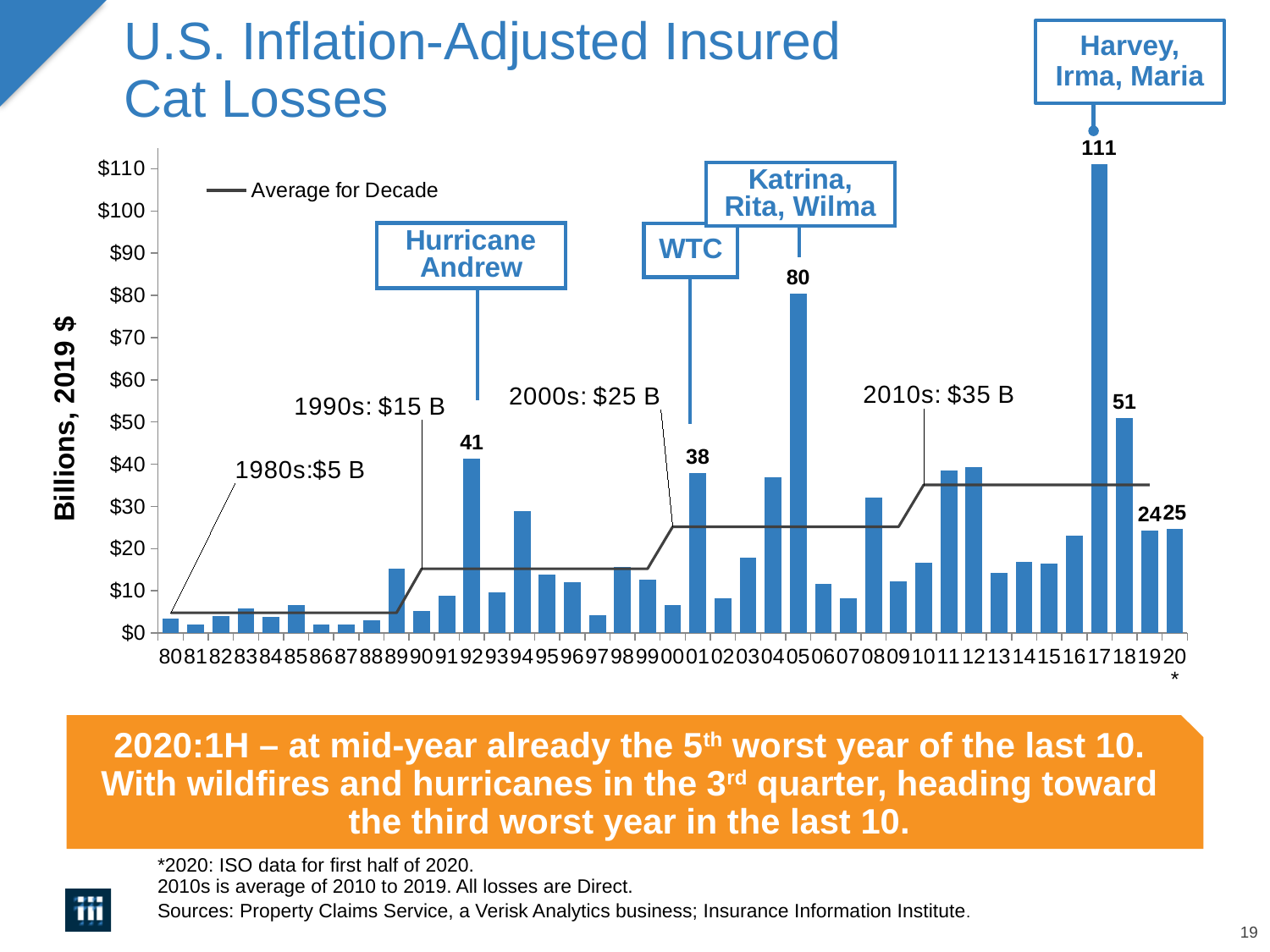
Which is larger, the value for 1992 or the value for 2001? 1992 What is the difference between the 2017 value and the 2005 value? 31 What is the difference between the 2018 value and the 2019 value? 27 What is the average for the 2010s decade shown on the chart? $35 B What is the value for 2005 (labeled '05')? 80 Is the value for 2011 greater or less than $30? greater Do the decade averages rise or fall from the 1980s to the 2010s? rise Which year has the highest insured cat losses? 2017 What is the value for 2017 (labeled '17')? 111 What kind of chart is this? combination bar and line chart How many years (bars) are shown on the x axis? 41 Is the value for 1989 greater or less than $20? less